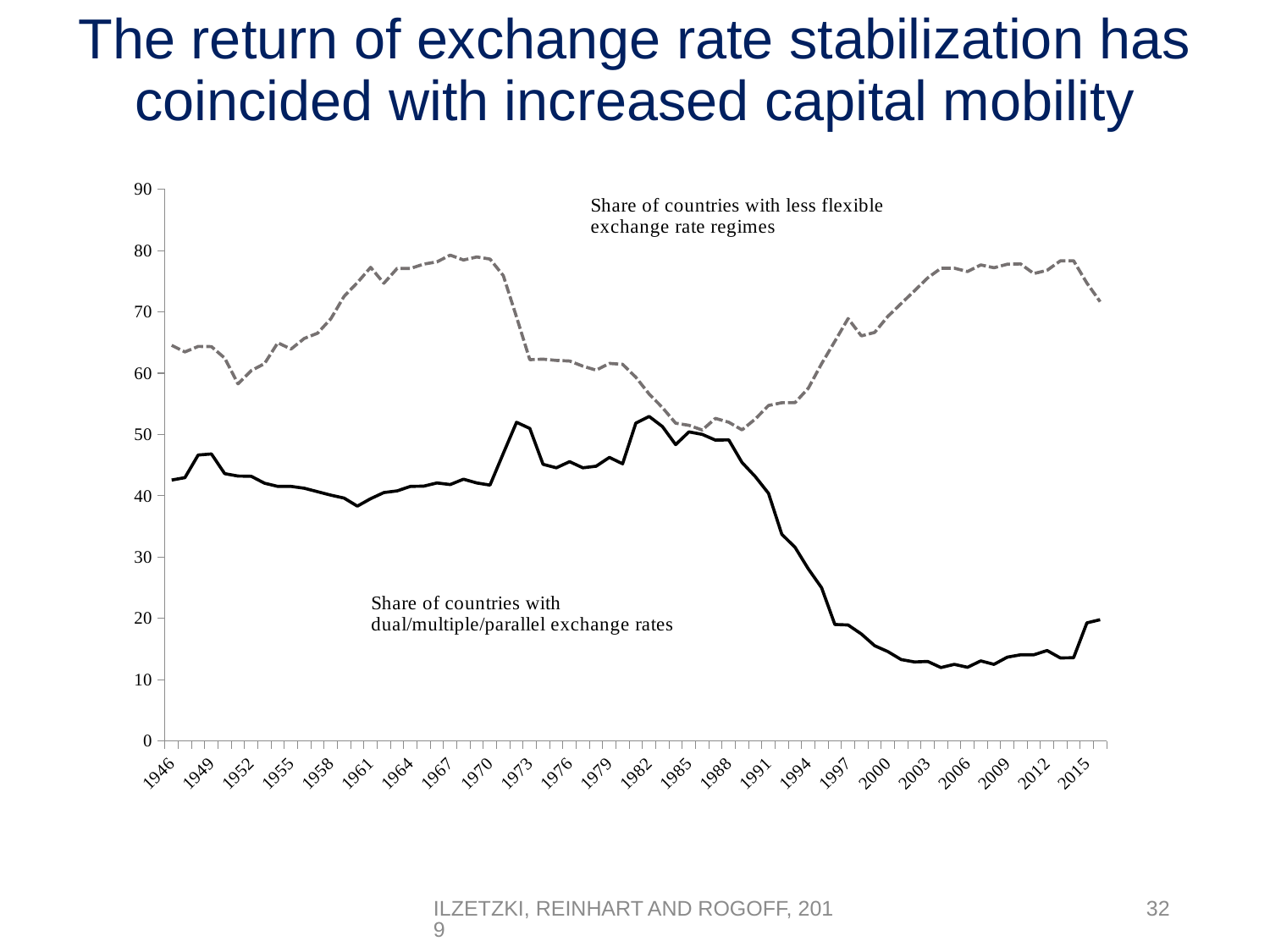
Which series is drawn with a dashed line? Share of countries with less flexible exchange rate regimes Does the share of countries with dual/multiple/parallel exchange rates rise or fall between 1988 and 2003? Fall In 2015, which series has the higher value: less flexible exchange rate regimes or dual/multiple/parallel exchange rates? Less flexible exchange rate regimes Is the share of countries with less flexible exchange rate regimes in 2015 greater or less than 70? greater Is the share of countries with less flexible exchange rate regimes in 1985 greater or less than 60? less Is the share of countries with dual/multiple/parallel exchange rates in 2003 greater or less than 20? less How many series are plotted on the chart? 2 What kind of chart is shown on the slide? Line chart Which series is drawn with a solid line? Share of countries with dual/multiple/parallel exchange rates Does the share of countries with less flexible exchange rate regimes rise or fall between 1988 and 2006? Rise